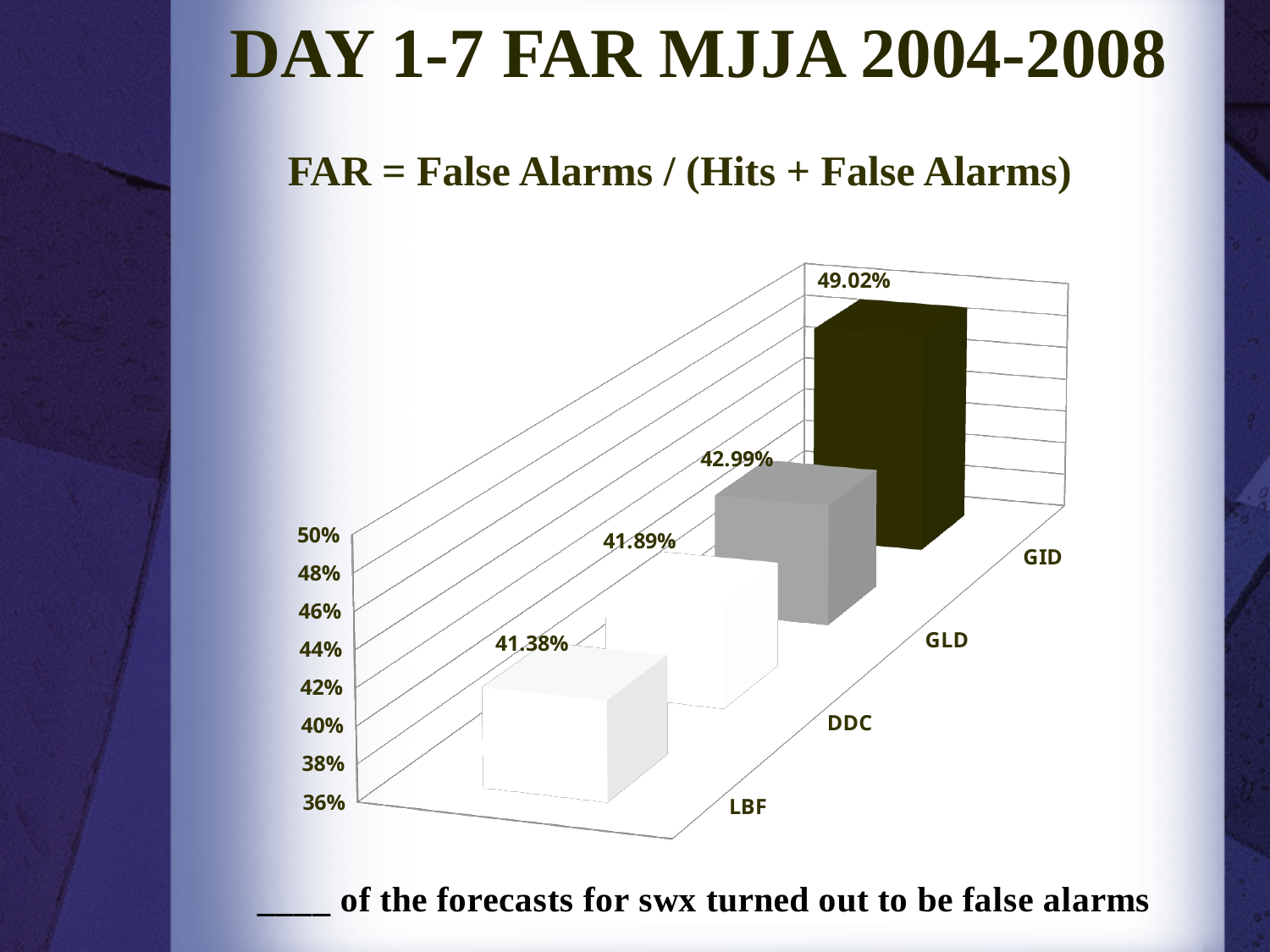
What is the FAR value for LBF? 41.38% What kind of chart is shown on the slide? Bar chart What is the FAR value for GID? 49.02% Which office has the highest FAR? GID Is the FAR value for GID greater or less than 46%? greater What is the FAR value for DDC? 41.89% How many offices are shown on the chart? 4 What is the difference between the FAR for GID and the FAR for LBF? 7.64% Which office has the lowest FAR? LBF Which is larger, the FAR for GID or the FAR for GLD? GID What is the FAR value for GLD? 42.99% What is the difference between the FAR for GID and the FAR for GLD? 6.03%